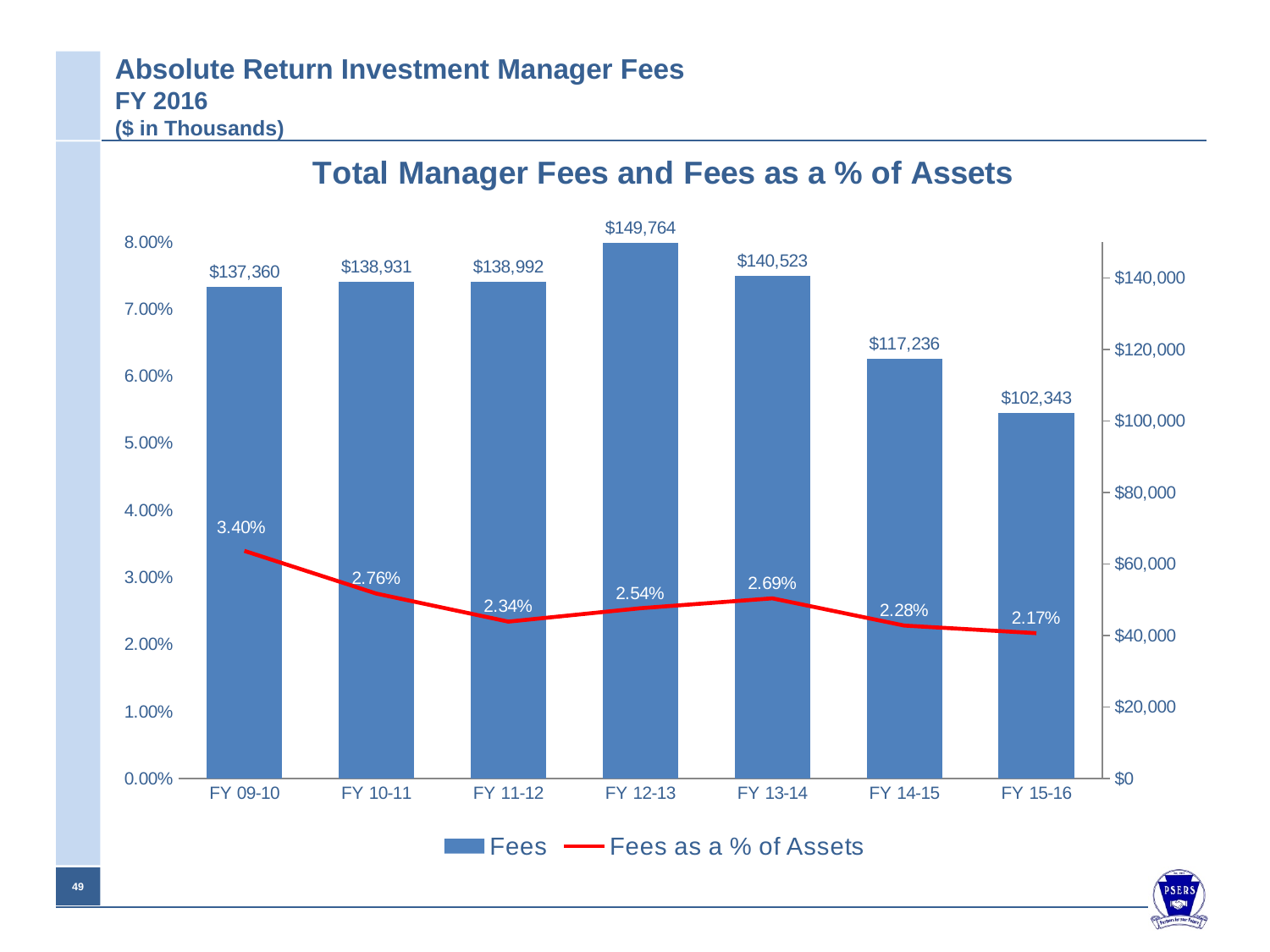
Is the Fees value for FY 15-16 greater or less than $120,000? less How many fiscal years are shown on the x axis? 7 What is the Fees value for FY 12-13? $149,764 By how many percentage points does Fees as a % of Assets differ between FY 09-10 and FY 15-16? 1.23 percentage points What is the Fees as a % of Assets value for FY 09-10? 3.40% What is the Fees value for FY 14-15? $117,236 Which is larger, the Fees for FY 13-14 or for FY 14-15? FY 13-14 What is the difference in Fees between FY 12-13 and FY 15-16? $47,421 How many series does the legend list? 2 Which fiscal year has the highest Fees? FY 12-13 Which fiscal year has the lowest Fees as a % of Assets? FY 15-16 What kind of chart is shown on the slide? A combination bar and line chart